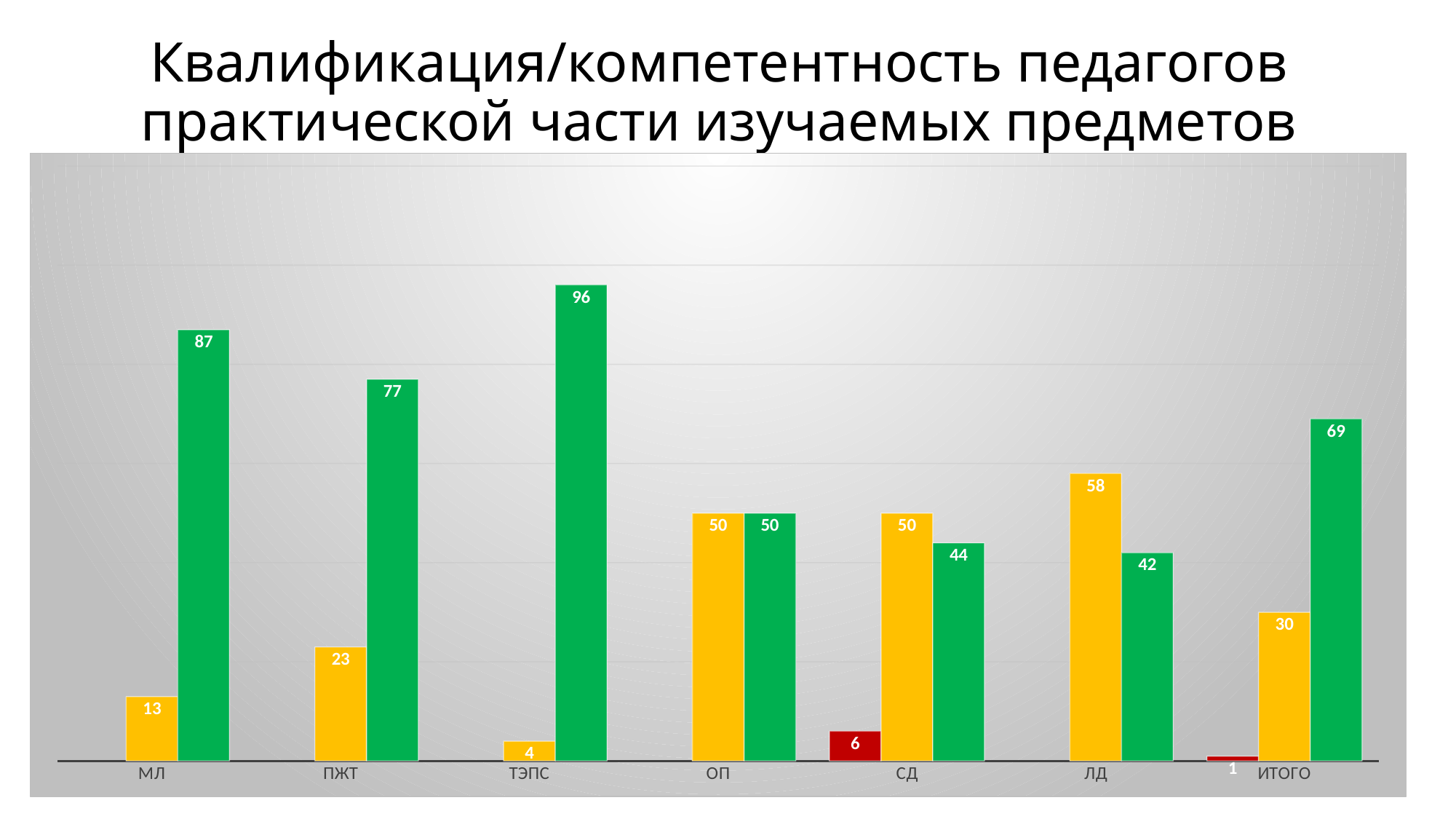
What is the value of the red bar for ИТОГО? 1 What is the value of the yellow bar for ЛД? 58 What is the value of the green bar for ТЭПС? 96 Which category has the highest green bar? ТЭПС How many categories are shown on the x axis of the chart? 7 How many categories have a red bar? 2 Which is larger for ЛД, the yellow bar or the green bar? the yellow bar What type of chart is shown on the slide? bar chart What is the difference between the green bar and the yellow bar for МЛ? 74 What is the difference between the green bars for ИТОГО and СД? 25 Which category has the lowest yellow bar? ТЭПС What is the value of the red bar for СД? 6